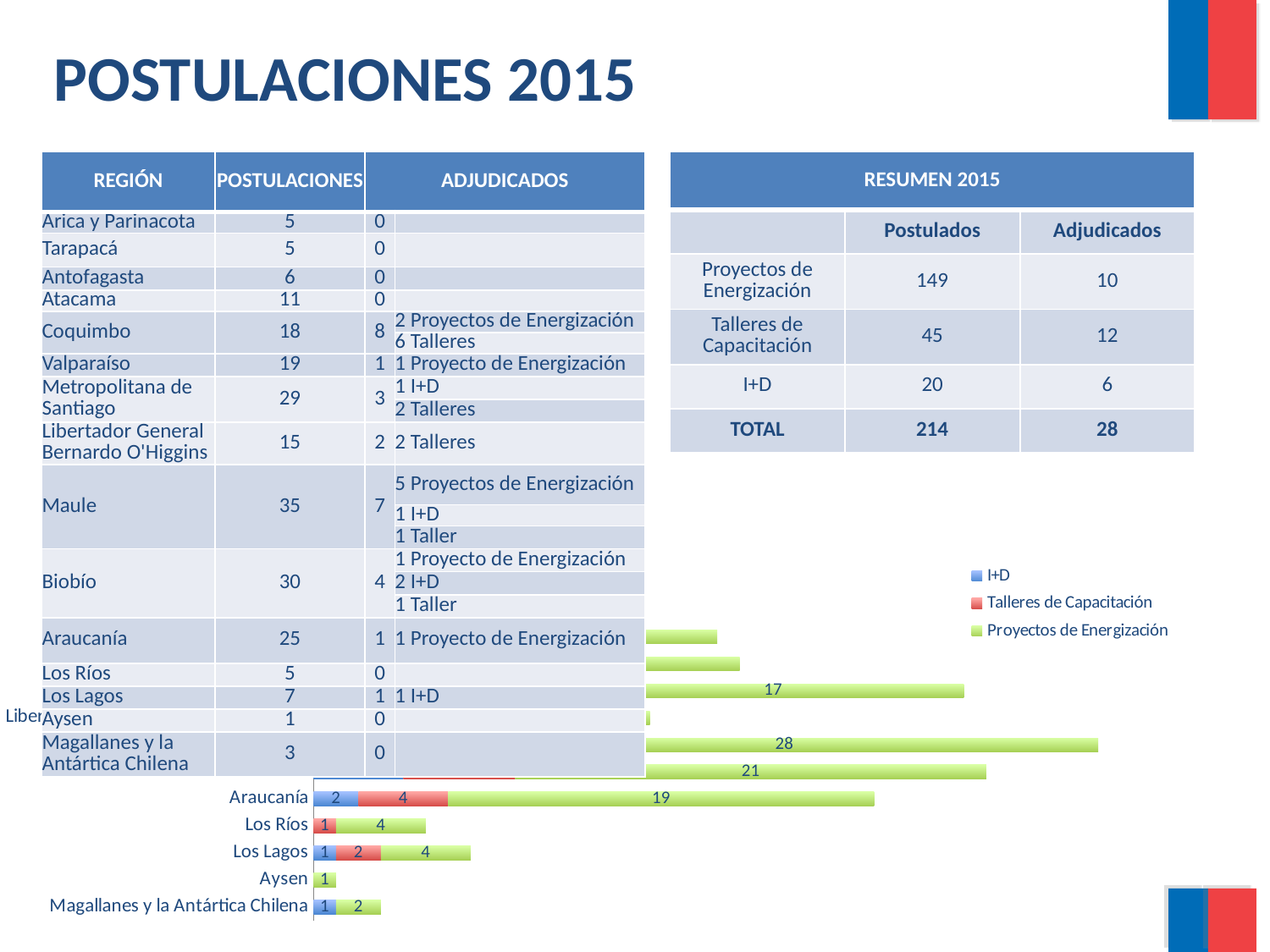
In the bar chart, what is the total of the stacked bar for Los Lagos? 7 How many series does the legend of the bar chart list? 3 In the bar chart, what is the value of Proyectos de Energización for Araucanía? 19 In the bar chart, what is the total of the stacked bar for Araucanía? 25 In the bar chart, what is the value of I+D for Araucanía? 2 Which series are listed in the legend of the bar chart? I+D, Talleres de Capacitación, Proyectos de Energización In the bar chart, what is the value of Talleres de Capacitación for Araucanía? 4 In the bar chart, what is the value of Proyectos de Energización for Magallanes y la Antártica Chilena? 2 In the bar chart, which is larger: Proyectos de Energización for Araucanía or for Los Ríos? Araucanía What kind of chart is shown at the bottom of the slide? bar chart In the bar chart, what is the value of Proyectos de Energización for Los Lagos? 4 In the bar chart, what is the value of Talleres de Capacitación for Los Lagos? 2